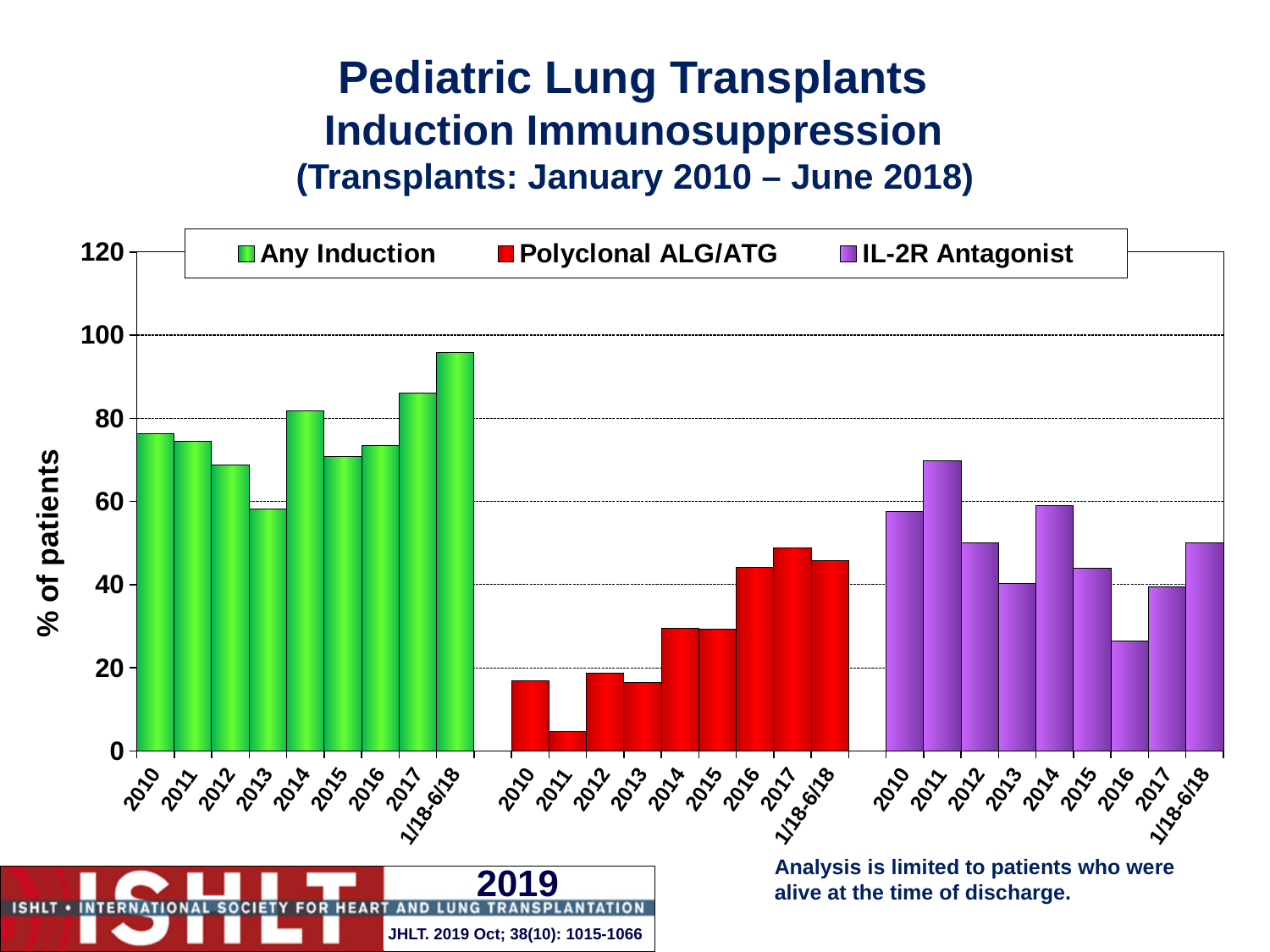
Is the value for Any Induction in 1/18-6/18 greater or less than 80? greater In 2010, which is larger: the value for Polyclonal ALG/ATG or the value for IL-2R Antagonist? IL-2R Antagonist What kind of chart is shown on the slide? Bar chart Which year has the lowest value for IL-2R Antagonist? 2016 Is the value for Polyclonal ALG/ATG in 2011 greater or less than 20? less Which time period has the highest value for Any Induction? 1/18-6/18 What colour are the bars for the IL-2R Antagonist series? Purple Which year has the lowest value for Polyclonal ALG/ATG? 2011 Which year has the highest value for IL-2R Antagonist? 2011 How many time periods are plotted for the Any Induction series? 9 How many series does the legend list? 3 Which year has the lowest value for Any Induction? 2013